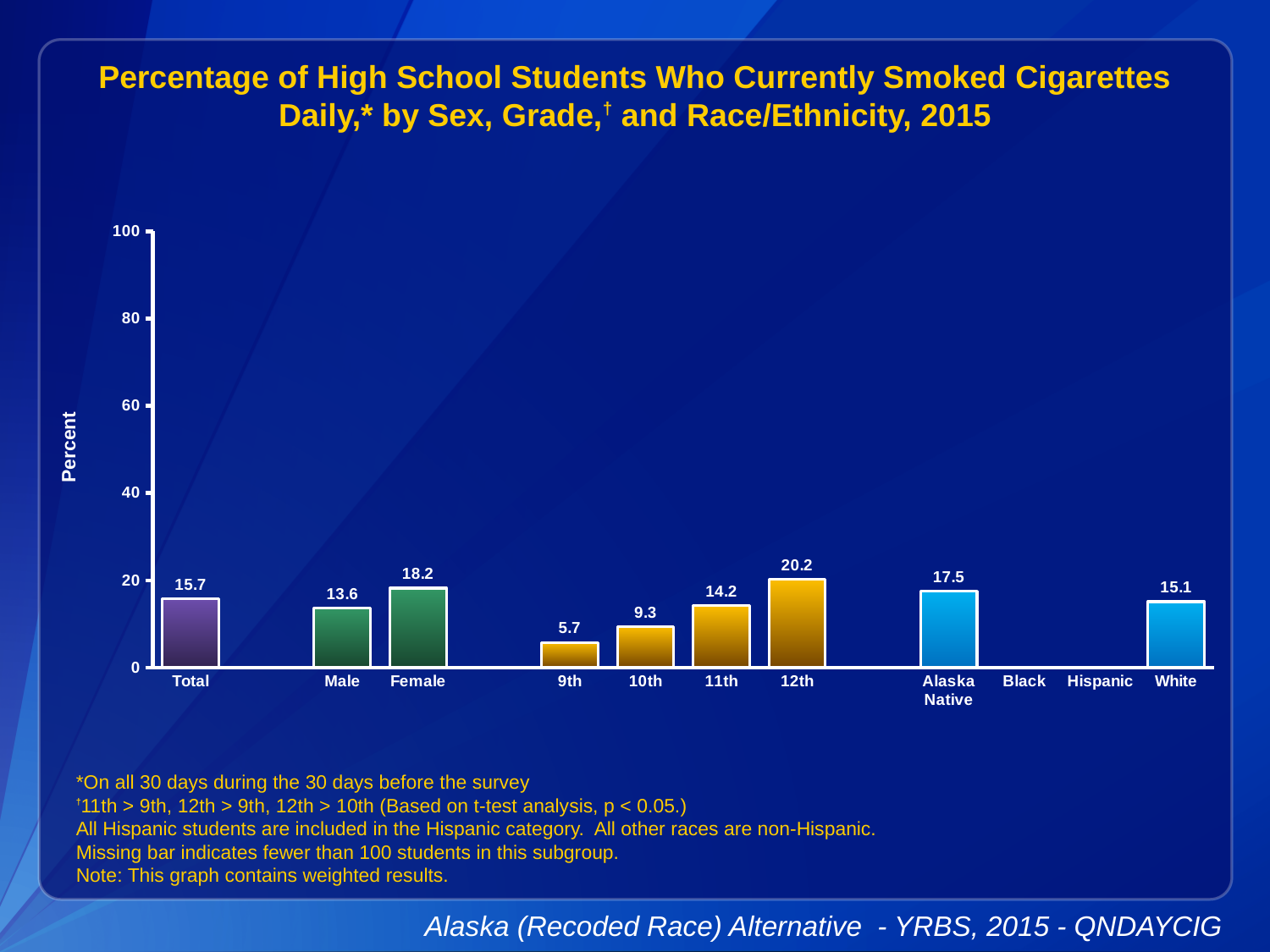
How many categories are labeled on the x axis? 11 Which is larger, the value for 11th grade or the value for 10th grade? 11th Which category has the highest value? 12th Among the categories with a bar shown, which has the lowest value? 9th What is the value for 9th grade? 5.7 Is the value for 12th grade greater or less than 20? greater What is the value for Alaska Native? 17.5 What is the difference between the values for Female and Male? 4.6 What is the value for Female? 18.2 What is the value for Total? 15.7 What kind of chart is this? bar chart Do the values rise or fall from 9th grade to 12th grade? rise